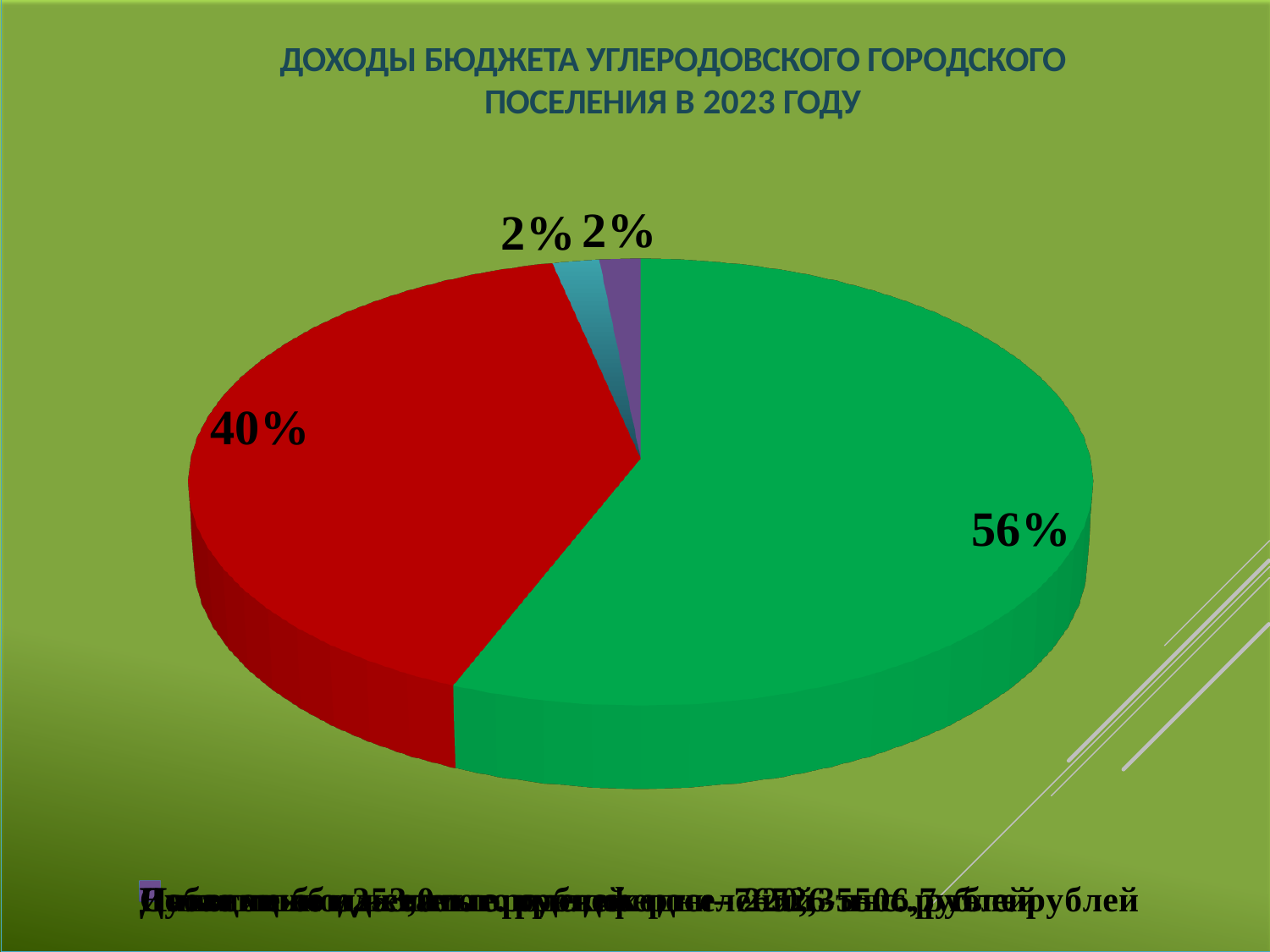
What share of the pie does the teal slice represent? 2% Which slice of the pie chart is the largest? the green slice (56%) What is the difference in percentage points between the green slice and the red slice? 16 What share of the pie does the purple slice represent? 2% What kind of chart is shown on the slide? pie chart How many slices does the pie chart have? 4 What share of the pie does the red slice represent? 40% What is the combined share of the two smallest slices of the pie? 4% Which is larger, the green slice or the red slice? the green slice What is the title of the chart on the slide? ДОХОДЫ БЮДЖЕТА УГЛЕРОДОВСКОГО ГОРОДСКОГО ПОСЕЛЕНИЯ В 2023 ГОДУ Is the share of the red slice greater or less than 50%? less